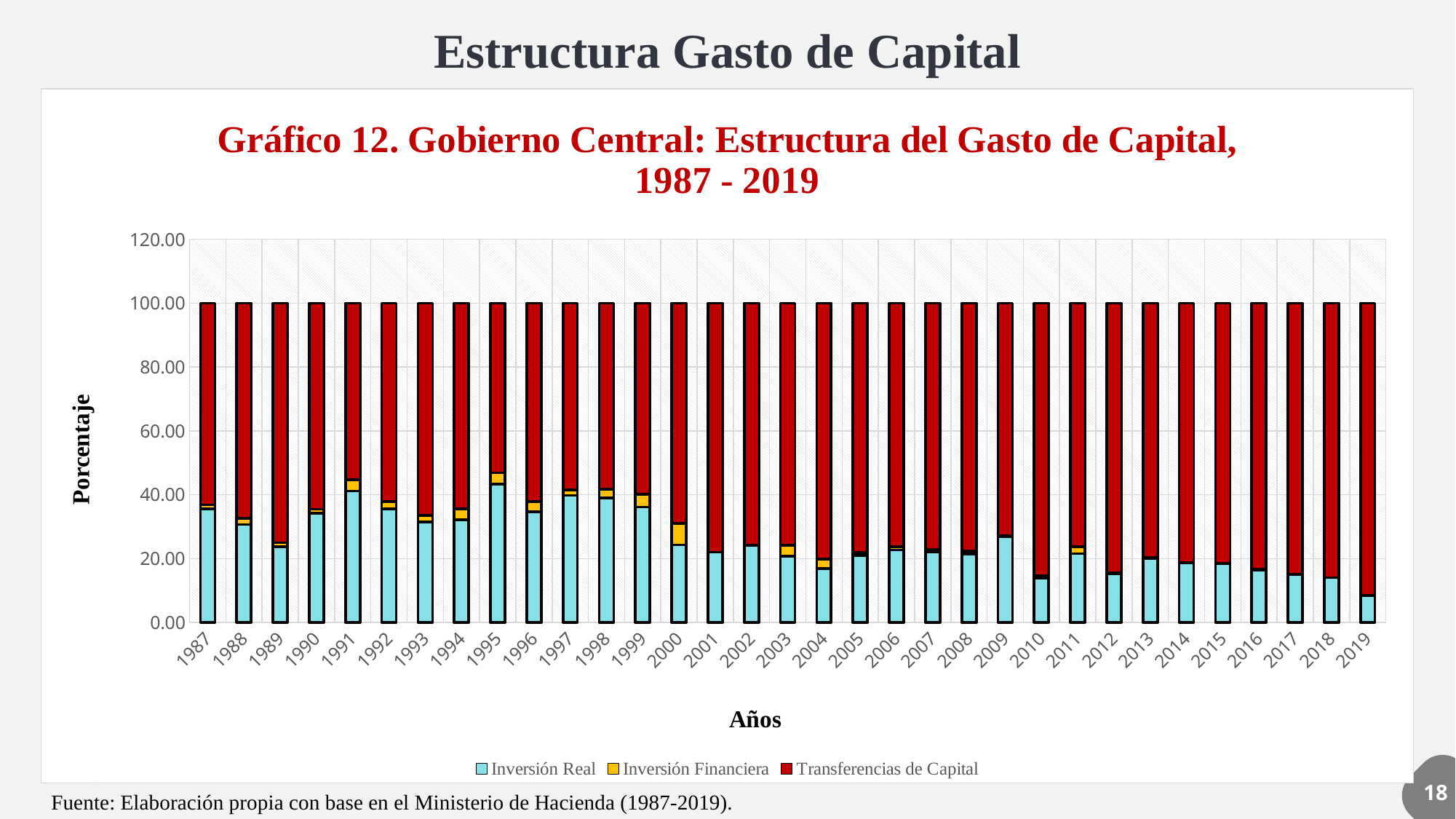
How many series does the legend list? 3 Is the value for Inversión Real in 2010 greater or less than 20.00? less How many years are shown on the x axis? 33 What is the label of the y axis? Porcentaje Is the value for Inversión Real in 2019 greater or less than 20.00? less Does the share of Inversión Real generally rise or fall from 1987 to 2019? fall Which is larger, Inversión Real in 1987 or Inversión Real in 2019? 1987 What is the total height of the stacked bar for 2005? 100.00 Is the value for Inversión Real in 1995 greater or less than 40.00? greater What kind of chart is shown on the slide? Stacked bar chart Which year has the largest Inversión Financiera segment? 2000 Which year has the lowest value for Inversión Real? 2019